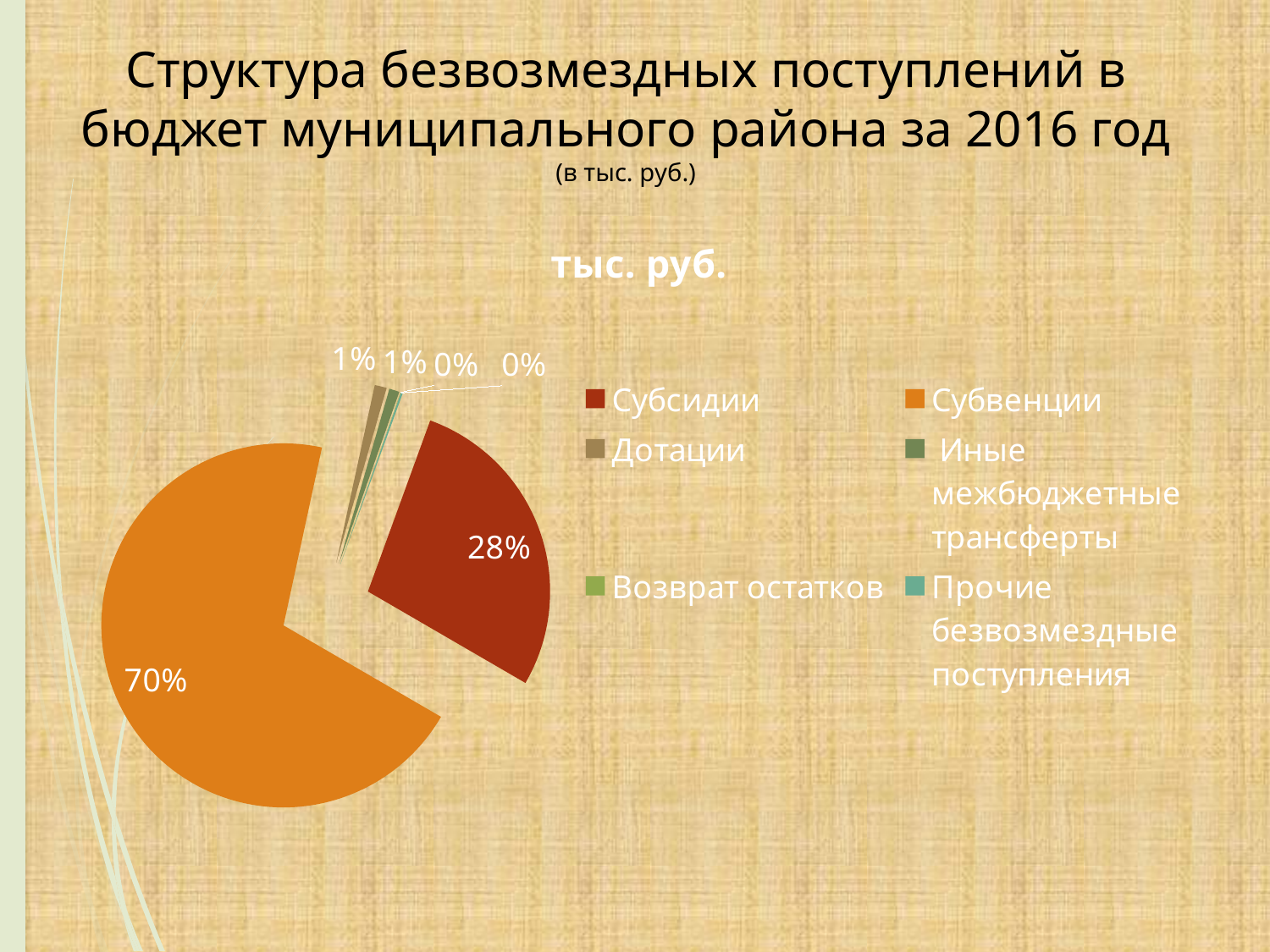
What share of the pie does Субвенции account for? 70% Which is larger, the share for Субсидии or the share for Субвенции? Субвенции How many categories does the legend list? 6 By how many percentage points does the share of Субвенции exceed the share of Субсидии? 42 percentage points Which category has the largest slice of the pie? Субвенции Which is larger, the share for Дотации or the share for Субсидии? Субсидии What kind of chart is shown on the slide? Pie chart What percentage is shown for Субсидии? 28% What colour is the slice for Субвенции? Orange What is the title of the chart? тыс. руб. What percentage is shown for Дотации? 1%